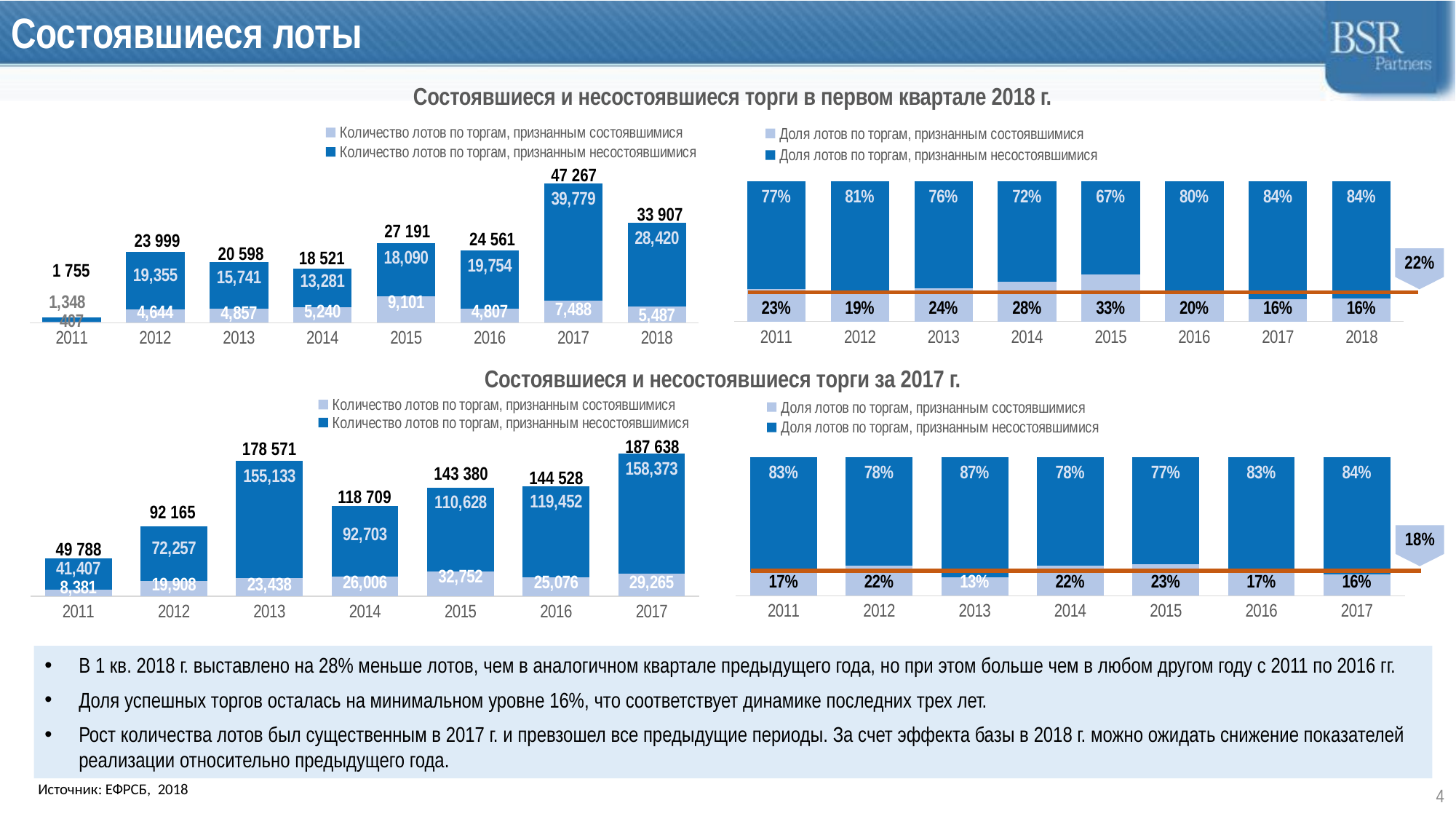
In the bottom-left count chart for full years, how many years are shown on the x axis? 7 In the bottom-left chart (Состоявшиеся и несостоявшиеся торги за 2017 г., counts), what is the total number of lots for 2013? 178 571 In the top-left chart (Состоявшиеся и несостоявшиеся торги в первом квартале 2018 г., counts), what is the total number of lots shown for 2017? 47 267 In the top-left count chart for the first quarter, which year has the highest total number of lots? 2017 In the top-left count chart for the first quarter, which year has the lowest total number of lots? 2011 In the top-left count chart for the first quarter, what is the value for 'Количество лотов по торгам, признанным несостоявшимися' in 2018? 28,420 In the bottom-left count chart for full years, which is larger: the total for 2015 or the total for 2016? 2016 In the bottom-right share chart for full years, what is the share of lots recognised as unsuccessful (несостоявшимися) in 2013? 87% In the top-left count chart for the first quarter, what is the difference between the totals for 2017 and 2018? 13 360 In the top-right share chart for the first quarter, which year has the highest share of successful lots? 2015 In the top-right share chart for the first quarter, what is the share of lots recognised as successful (состоявшимися) in 2015? 33% What type of chart is the bottom-left chart showing counts of lots for 2011–2017? Stacked bar chart